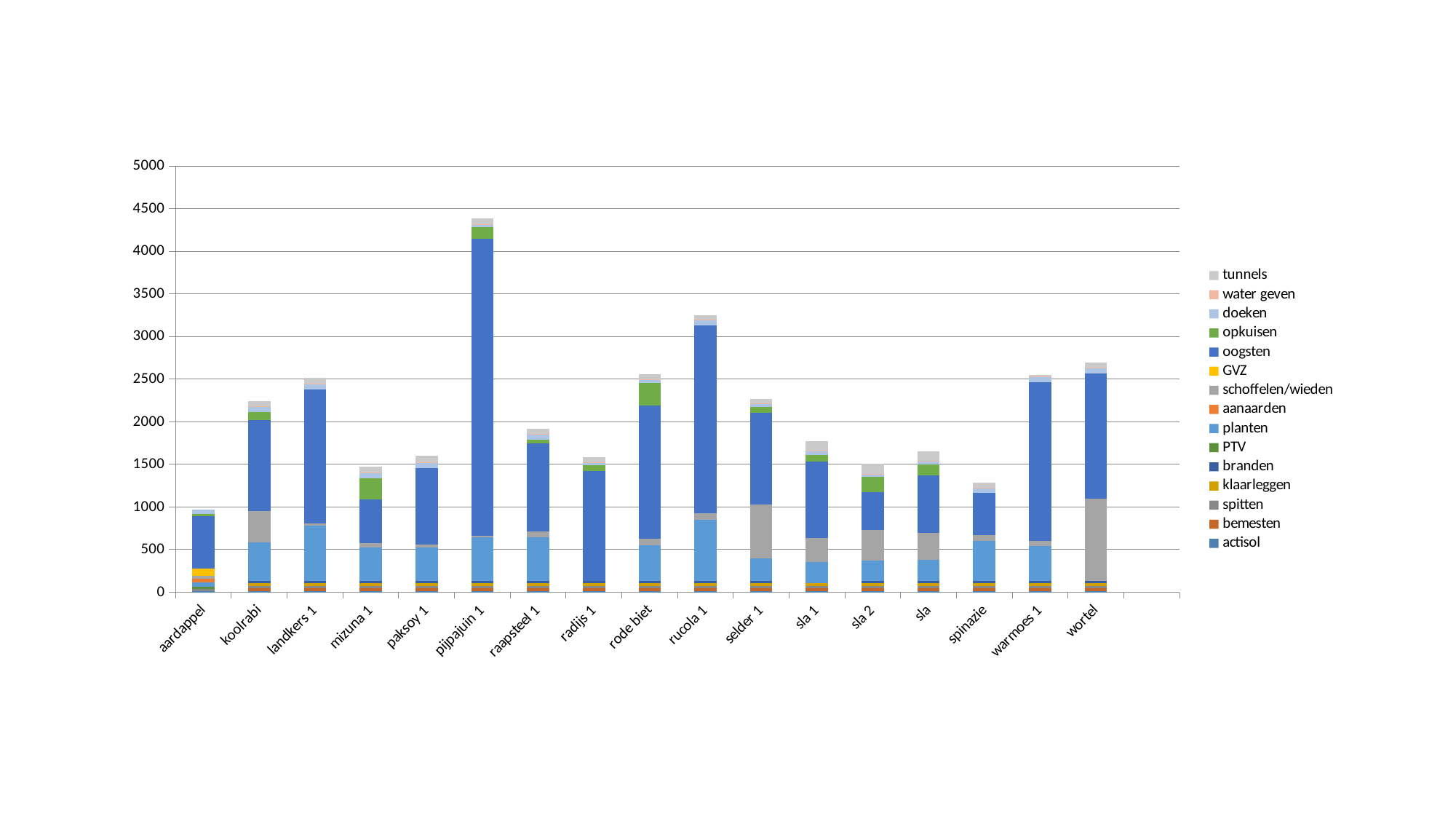
Which has the larger total, landkers 1 or mizuna 1? landkers 1 What kind of chart is shown on the slide? stacked bar chart Which has the larger total, rucola 1 or rode biet? rucola 1 Is the total for aardappel greater or less than 1000? less Which category has the tallest stacked bar? pijpajuin 1 How many categories are shown on the x axis of the chart? 17 Is the total for rucola 1 greater or less than 3000? greater Is the total for spinazie greater or less than 1500? less How many series does the legend list? 15 Which series is listed first in the legend? tunnels Which category has the shortest stacked bar? aardappel